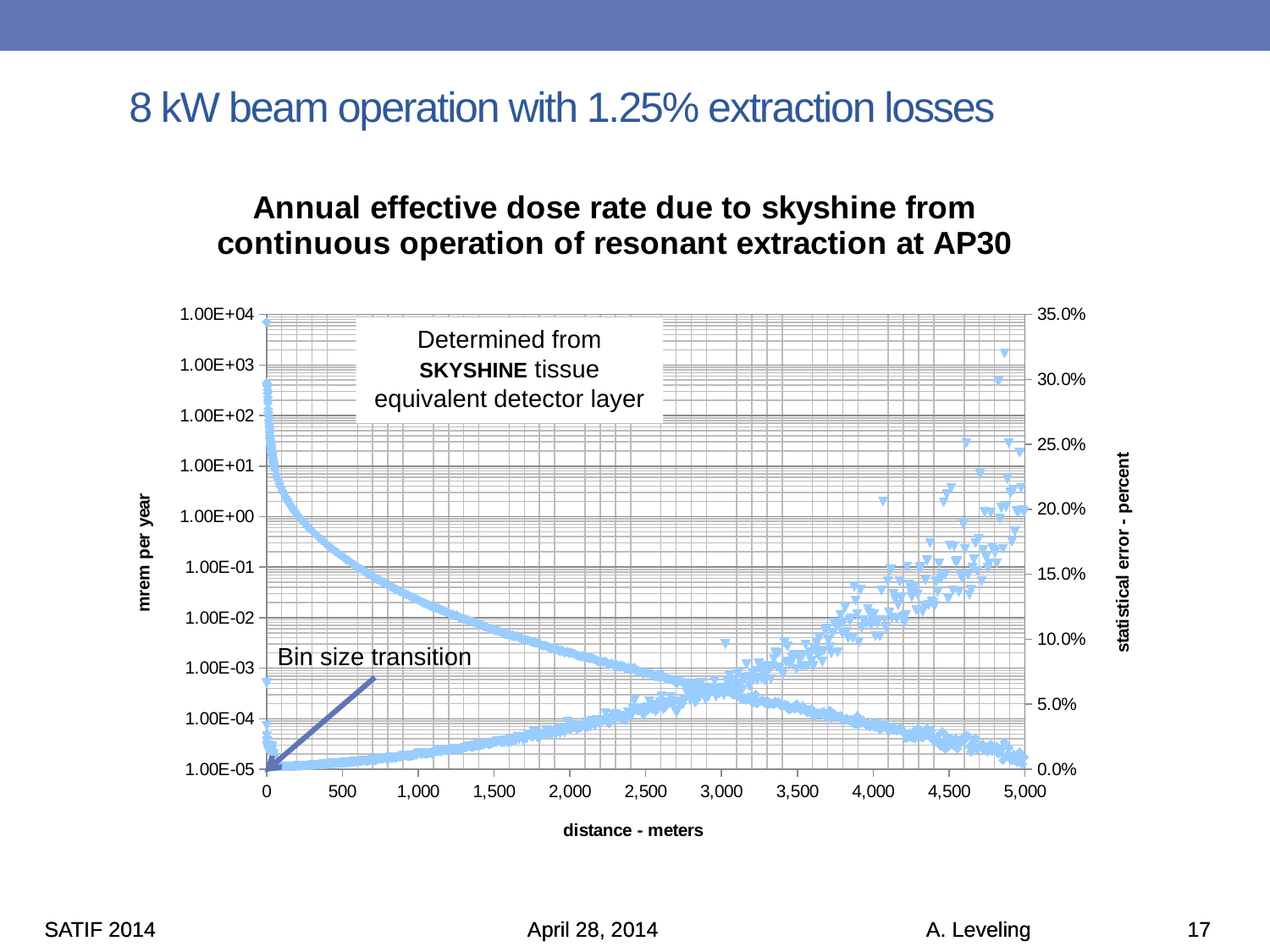
Is the dose rate at a distance of 4,000 meters greater or less than 1.00E-03 mrem per year? less Is the dose rate at a distance of 2,500 meters greater or less than 1.00E-02 mrem per year? less What kind of chart is shown on the slide? scatter chart Which is larger: the dose rate at 1,000 meters or the dose rate at 3,000 meters? the dose rate at 1,000 meters Is the statistical error at a distance of 1,000 meters greater or less than 5.0%? less Does the statistical error (percent) rise or fall as distance increases along the x axis? rise Which is larger: the statistical error at 2,000 meters or the statistical error at 4,000 meters? the statistical error at 4,000 meters Does the annual effective dose rate (mrem per year) rise or fall as distance increases along the x axis? fall What quantity is plotted on the right-hand vertical axis? statistical error - percent What is the title of the chart? Annual effective dose rate due to skyshine from continuous operation of resonant extraction at AP30